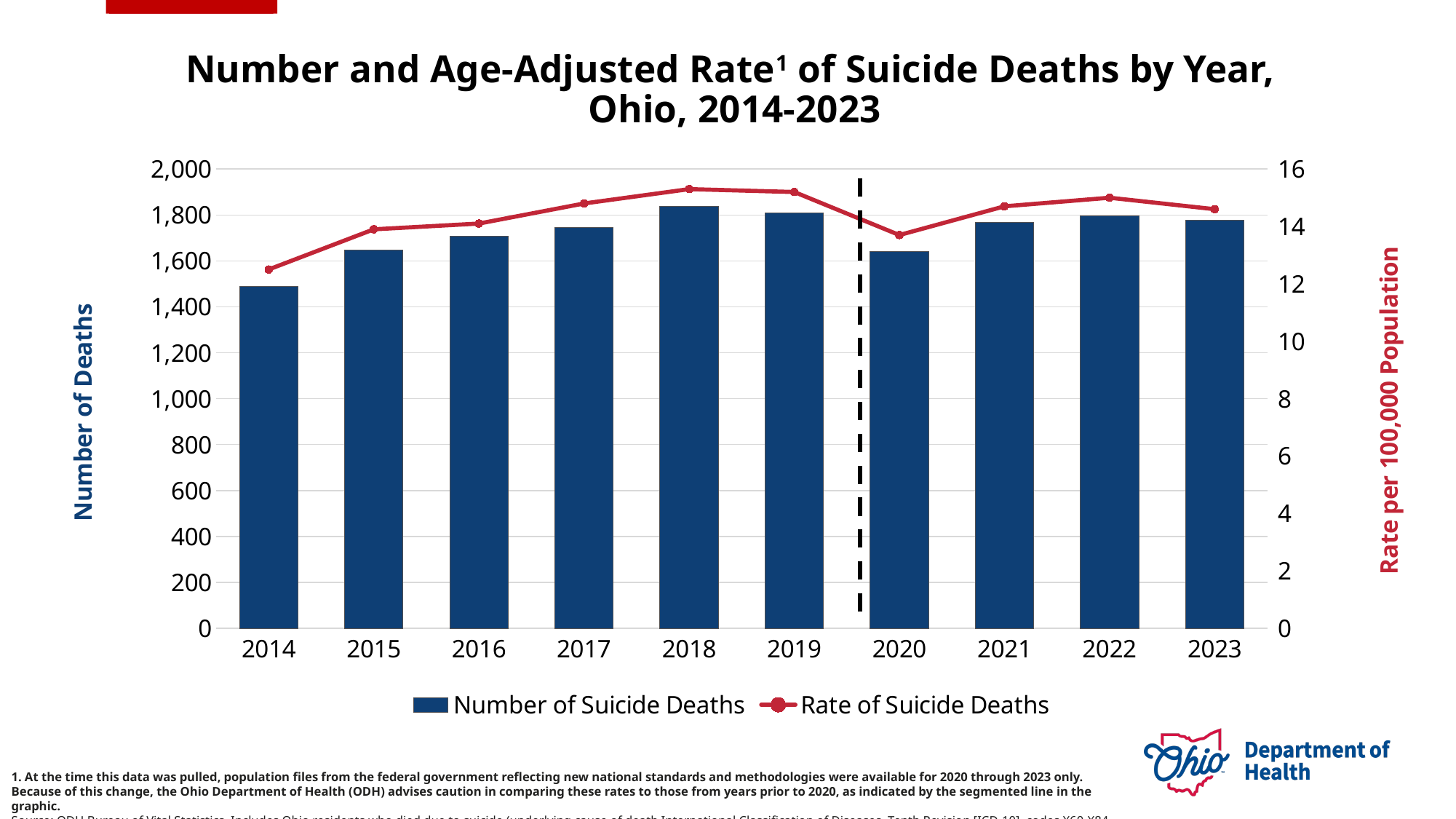
Is the number of suicide deaths in 2018 greater or less than 1,800? greater Is the number of suicide deaths in 2014 greater or less than 1,600? less Which year has the highest number of suicide deaths? 2018 What kind of chart is shown on the slide? A combination bar and line chart What does the right-hand vertical axis of the chart measure? Rate per 100,000 Population How many years are shown on the x axis of the chart? 10 Do the number of suicide deaths rise or fall from 2014 to 2018? rise Which year has the lowest number of suicide deaths? 2014 How many series does the chart's legend list? 2 Which year has more suicide deaths, 2018 or 2020? 2018 Is the rate of suicide deaths in 2014 greater or less than 14 per 100,000 population? less Which year has the lowest rate of suicide deaths? 2014